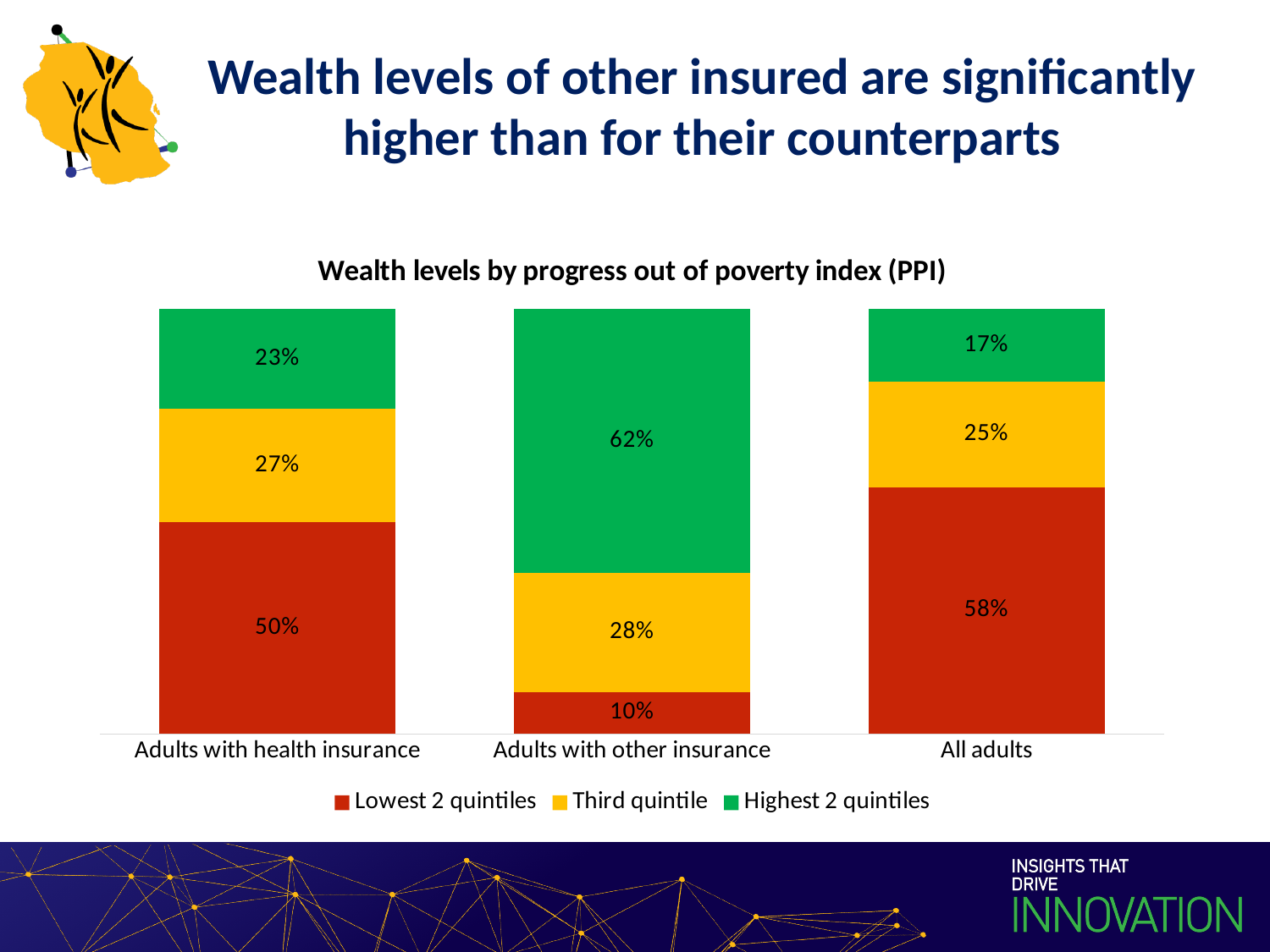
What is the value for Lowest 2 quintiles for Adults with health insurance? 50% What is the title of the chart? Wealth levels by progress out of poverty index (PPI) Which is larger: the Third quintile value for Adults with other insurance or for All adults? Adults with other insurance Which category has the highest value for Lowest 2 quintiles? All adults How many categories are shown on the x axis? 3 What is the value for Lowest 2 quintiles for Adults with other insurance? 10% What is the value for Third quintile for All adults? 25% What kind of chart is shown? Stacked bar chart How many series does the legend list? 3 Which category has the lowest value for Highest 2 quintiles? All adults What is the value for Highest 2 quintiles for Adults with other insurance? 62% What is the difference between the Highest 2 quintiles values for Adults with other insurance and Adults with health insurance? 39%